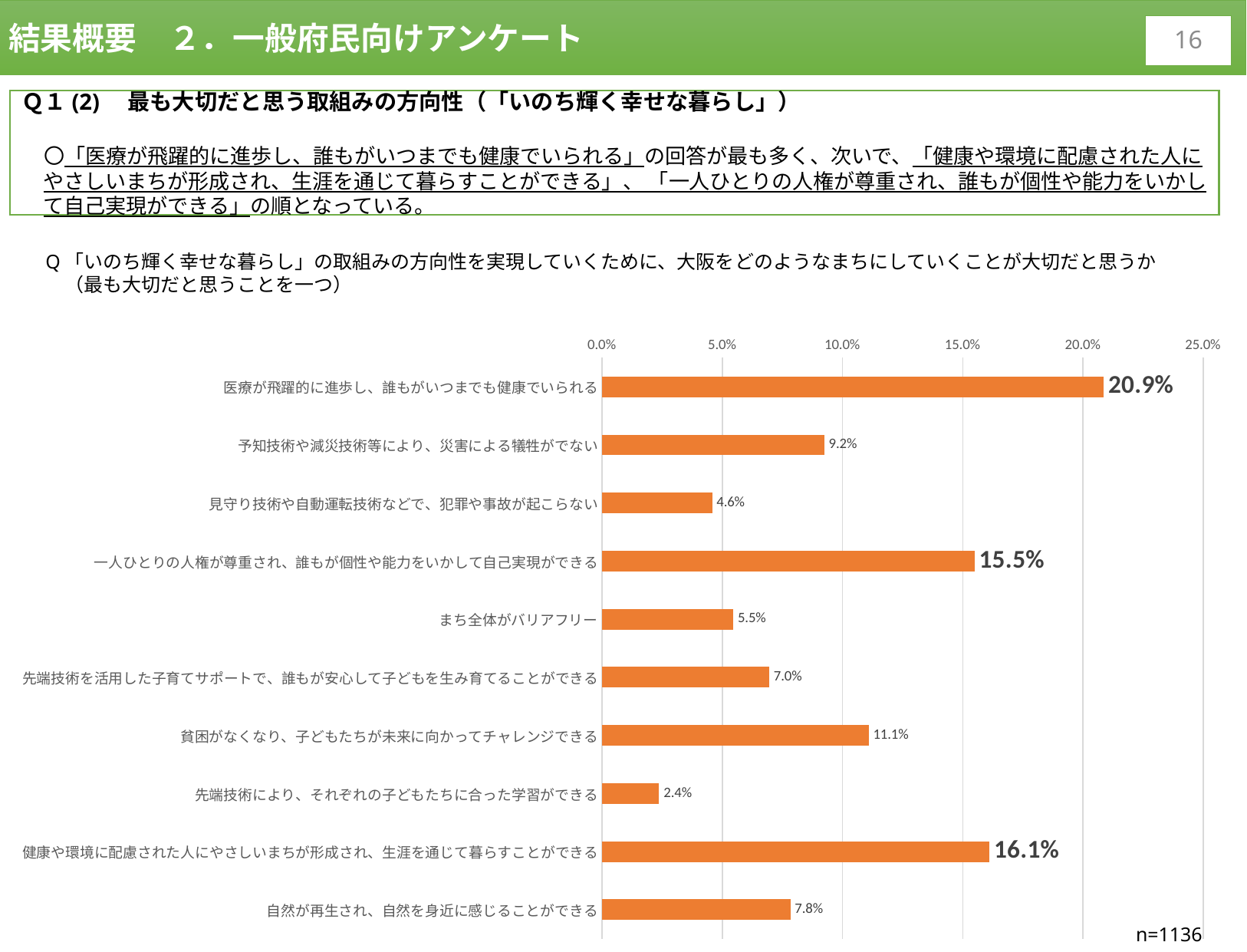
What is the difference between the values for 「健康や環境に配慮された人にやさしいまちが形成され、生涯を通じて暮らすことができる」 and 「一人ひとりの人権が尊重され、誰もが個性や能力をいかして自己実現ができる」? 0.6% What is the sample size (n) shown on the chart? n=1136 What is the value for 「医療が飛躍的に進歩し、誰もがいつまでも健康でいられる」? 20.9% How many categories are shown in the chart? 10 Which category has the lowest value? 先端技術により、それぞれの子どもたちに合った学習ができる Which category has the highest value? 医療が飛躍的に進歩し、誰もがいつまでも健康でいられる What is the value for 「まち全体がバリアフリー」? 5.5% What kind of chart is shown on the slide? bar chart Which is larger: the value for 「予知技術や減災技術等により、災害による犠牲がでない」 or 「自然が再生され、自然を身近に感じることができる」? 予知技術や減災技術等により、災害による犠牲がでない What is the maximum value shown on the percentage axis? 25.0% What is the value for 「貧困がなくなり、子どもたちが未来に向かってチャレンジできる」? 11.1% Is the value for 「先端技術を活用した子育てサポートで、誰もが安心して子どもを生み育てることができる」 greater or less than 5.0%? greater